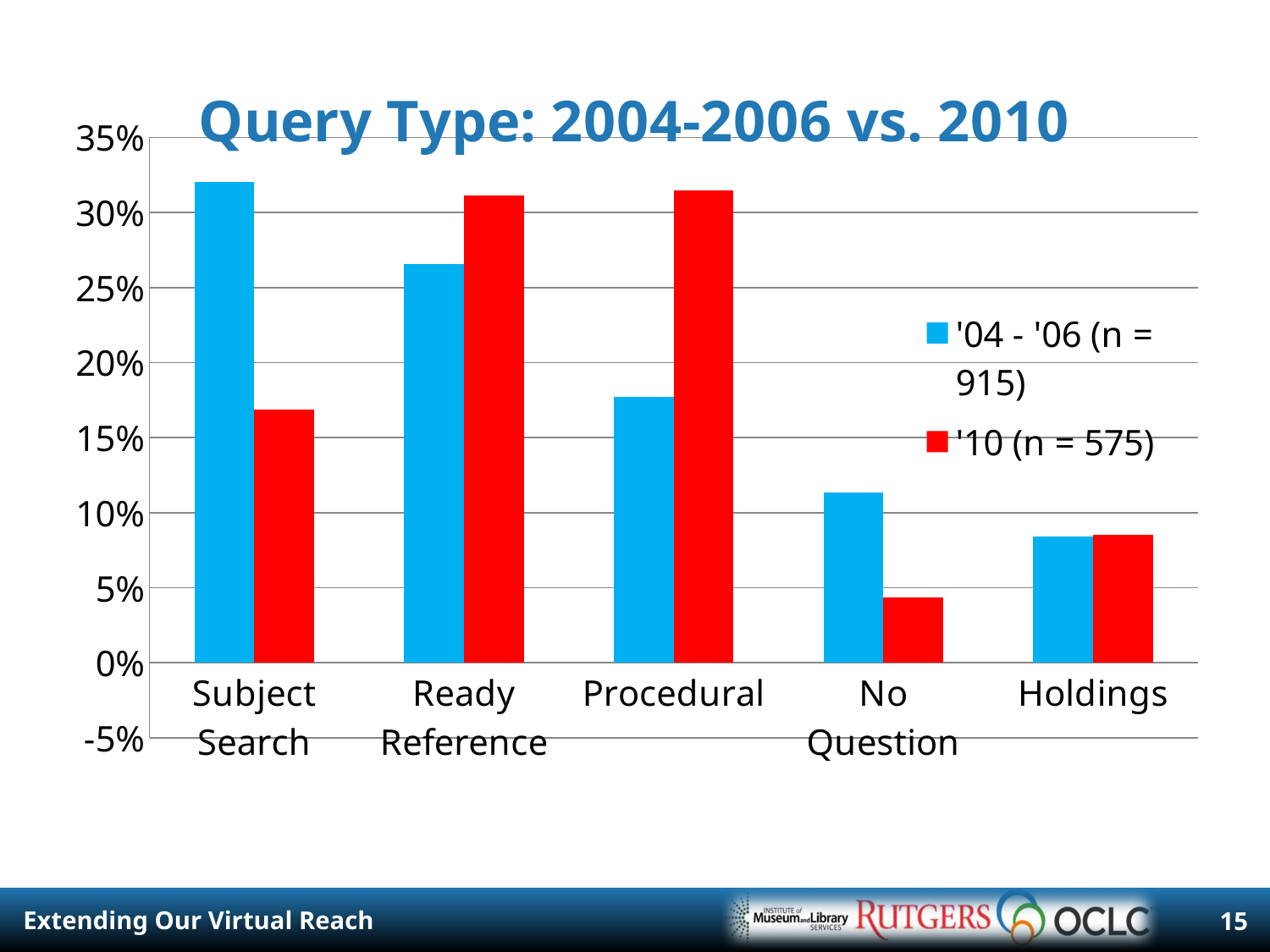
How many series does the legend list? 2 Which query type has the highest value for the '04 - '06 (n = 915) series? Subject Search What is the title of the chart? Query Type: 2004-2006 vs. 2010 Is the '04 - '06 (n = 915) value for Subject Search greater or less than 30%? greater For Procedural, which series has the larger value: '04 - '06 (n = 915) or '10 (n = 575)? '10 (n = 575) Is the '10 (n = 575) value for No Question greater or less than 5%? less What kind of chart is shown on the slide? bar chart Which query type has the lowest value for the '04 - '06 (n = 915) series? Holdings Is the '04 - '06 (n = 915) value for Procedural greater or less than 20%? less How many query type categories are shown on the x axis? 5 For Subject Search, which series has the larger value: '04 - '06 (n = 915) or '10 (n = 575)? '04 - '06 (n = 915) Which query type has the lowest value for the '10 (n = 575) series? No Question